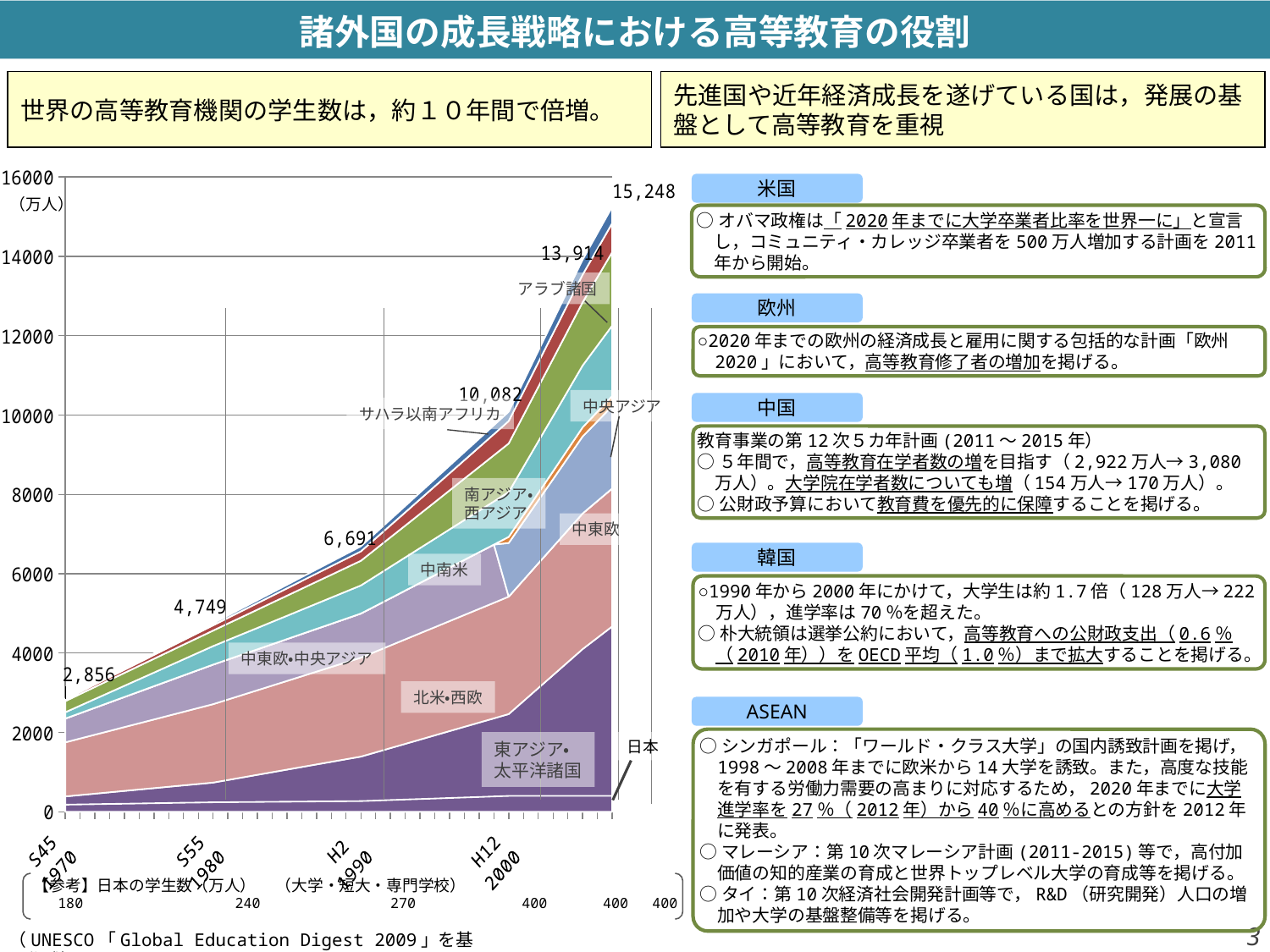
What is the total value labeled for 1980 (S55) on the chart? 4,749 What is the total value labeled for 1970 (S45) on the chart? 2,856 What is the difference between the labeled totals for 2000 and 1970? 7,226 What kind of chart is shown on the slide? stacked area chart What is the total value labeled for 1990 (H2) on the chart? 6,691 What is the difference between the labeled totals for 1990 and 1980? 1,942 What unit is shown on the y axis of the chart? 万人 What is the lowest total value labeled on the chart? 2,856 Do the total values rise or fall from 1970 to the last point on the chart? rise Which is larger, the labeled total for 1980 or for 1990? 1990 What is the highest total value labeled on the chart? 15,248 What is the total value labeled for 2000 (H12) on the chart? 10,082